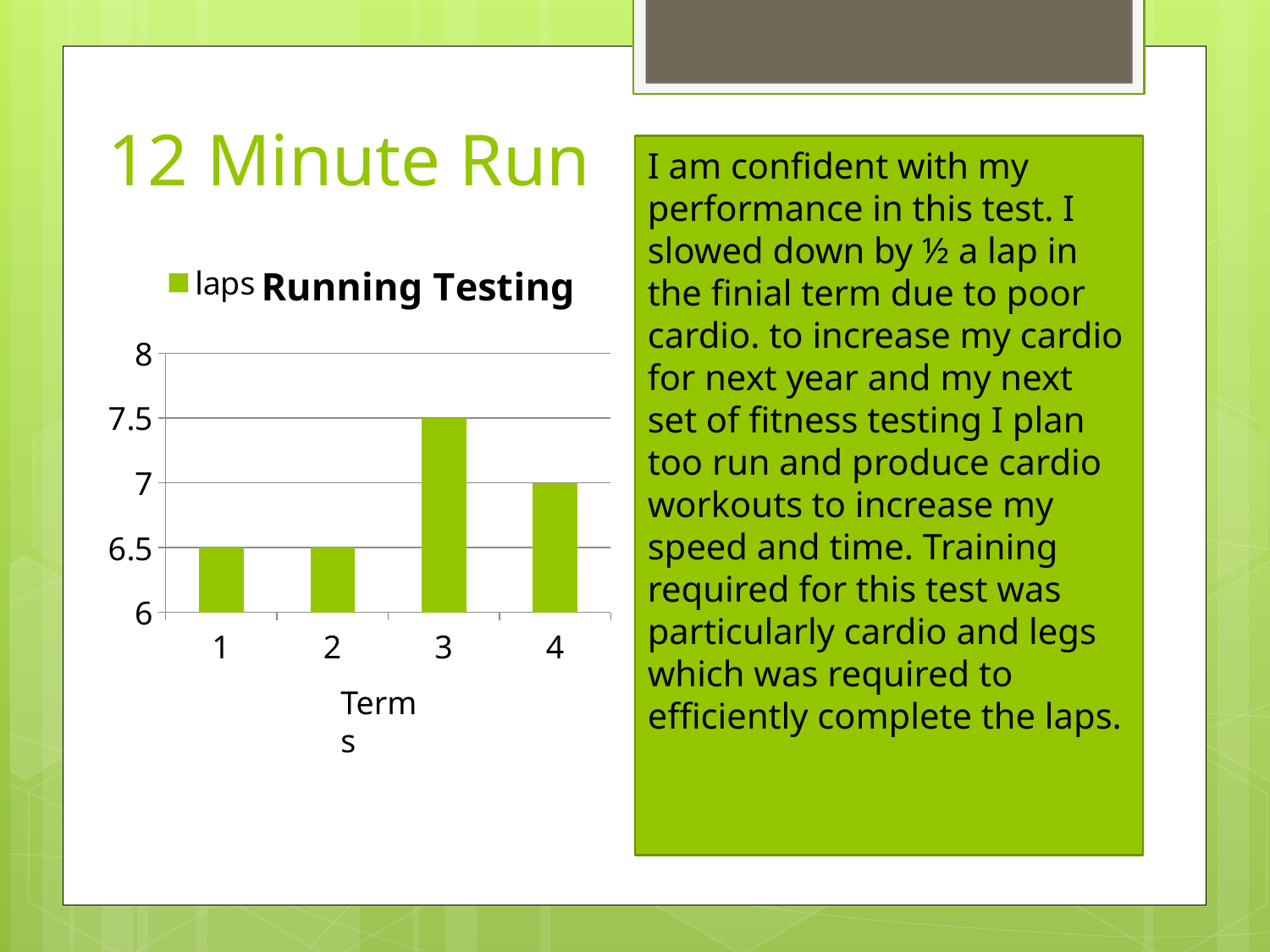
Which is larger, the value for Term 3 or the value for Term 4? Term 3 What kind of chart is shown on the slide? bar chart How many series does the chart legend list? 1 What is the value for Term 3 in the Running Testing chart? 7.5 How many terms are shown on the x axis of the chart? 4 What is the value for Term 4 in the Running Testing chart? 7 Is the value for Term 2 greater or less than 7? less What is the difference between the values for Term 3 and Term 1? 1 What is the value for Term 1 in the Running Testing chart? 6.5 Which term has the highest value in the Running Testing chart? 3 What is the title of the chart on the slide? Running Testing What is the difference between the values for Term 3 and Term 4? 0.5